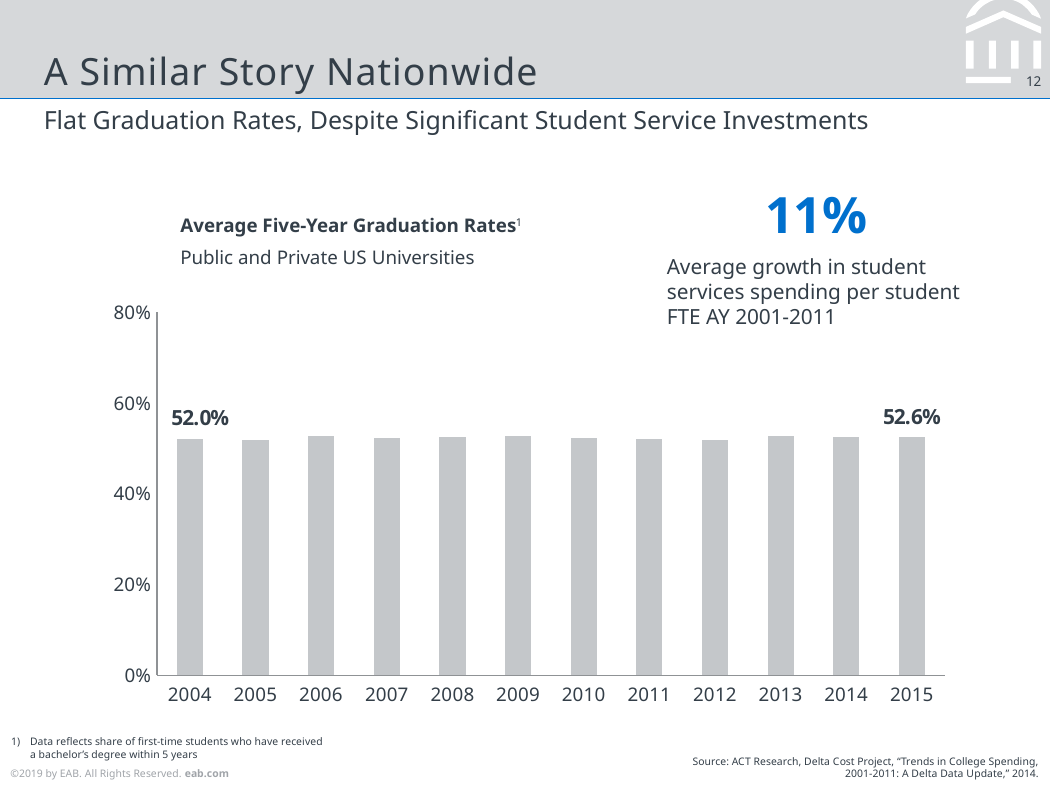
Is the graduation rate for 2008 greater or less than 60%? less Is the graduation rate for 2010 greater or less than 40%? greater Do the graduation rates rise sharply, fall sharply, or stay roughly flat from 2004 to 2015? Stay roughly flat What is the first year shown on the x axis of the chart? 2004 What is the highest value shown on the chart's y axis? 80% What is the title of the chart? Average Five-Year Graduation Rates By how many percentage points does the 2015 graduation rate exceed the 2004 rate? 0.6 percentage points Which year has the higher labeled graduation rate, 2004 or 2015? 2015 What kind of chart is used to show the average five-year graduation rates? Bar chart What is the average five-year graduation rate shown for 2004? 52.0% How many years are plotted on the x axis of the graduation rates chart? 12 What is the average five-year graduation rate shown for 2015? 52.6%